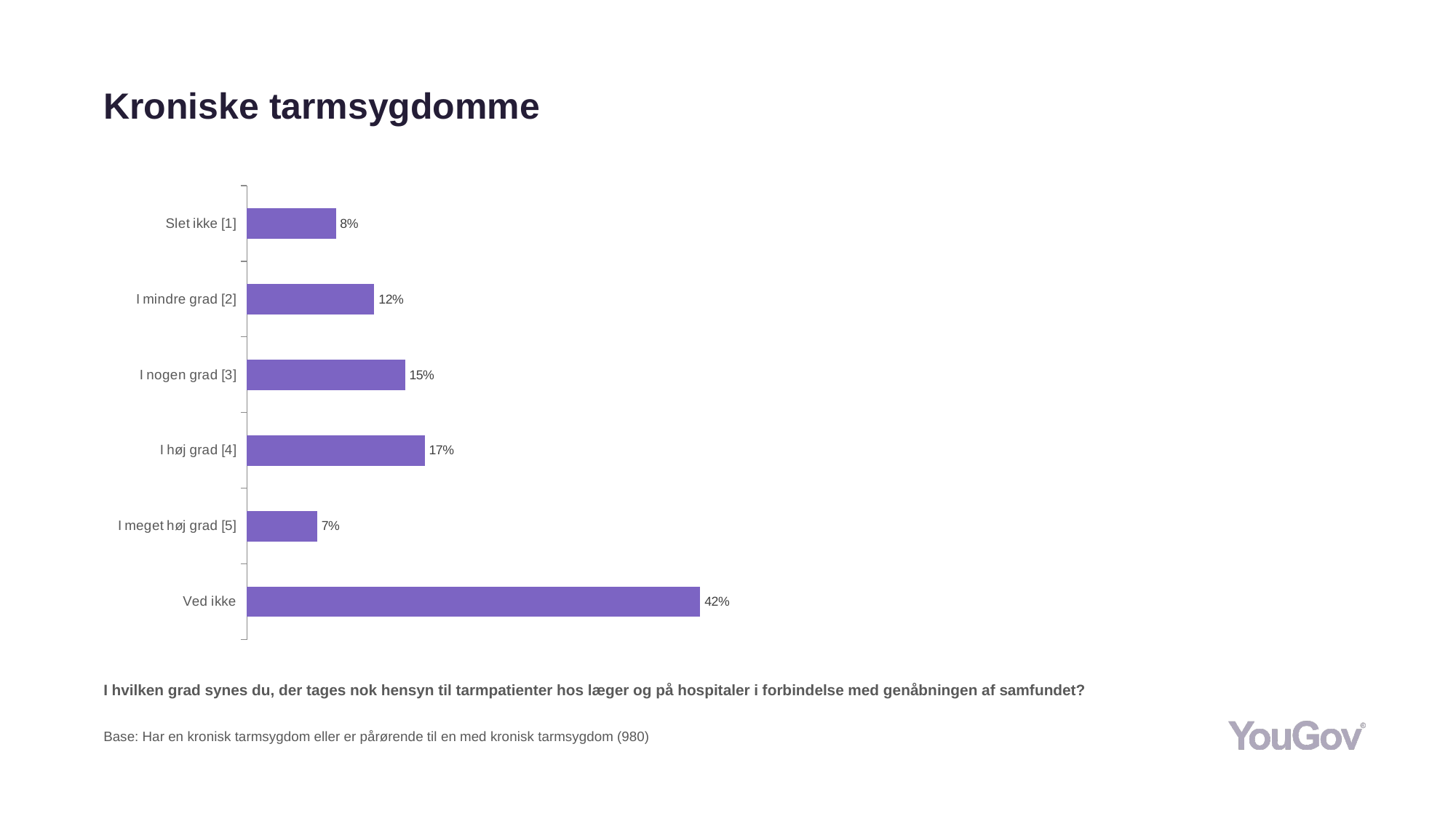
What is the difference between the values for "Ved ikke" and "I høj grad [4]"? 25% Which category has the highest value? Ved ikke Which category has the lowest value? I meget høj grad [5] What is the value for "I nogen grad [3]"? 15% What is the value for "I høj grad [4]"? 17% What is the difference between the values for "I mindre grad [2]" and "Slet ikke [1]"? 4% What kind of chart is shown on the slide? Bar chart What is the value for "Slet ikke [1]"? 8% What is the value for "Ved ikke"? 42% How many categories are shown in the chart? 6 What is the title of the slide? Kroniske tarmsygdomme Which is larger, the value for "I nogen grad [3]" or the value for "I mindre grad [2]"? I nogen grad [3]